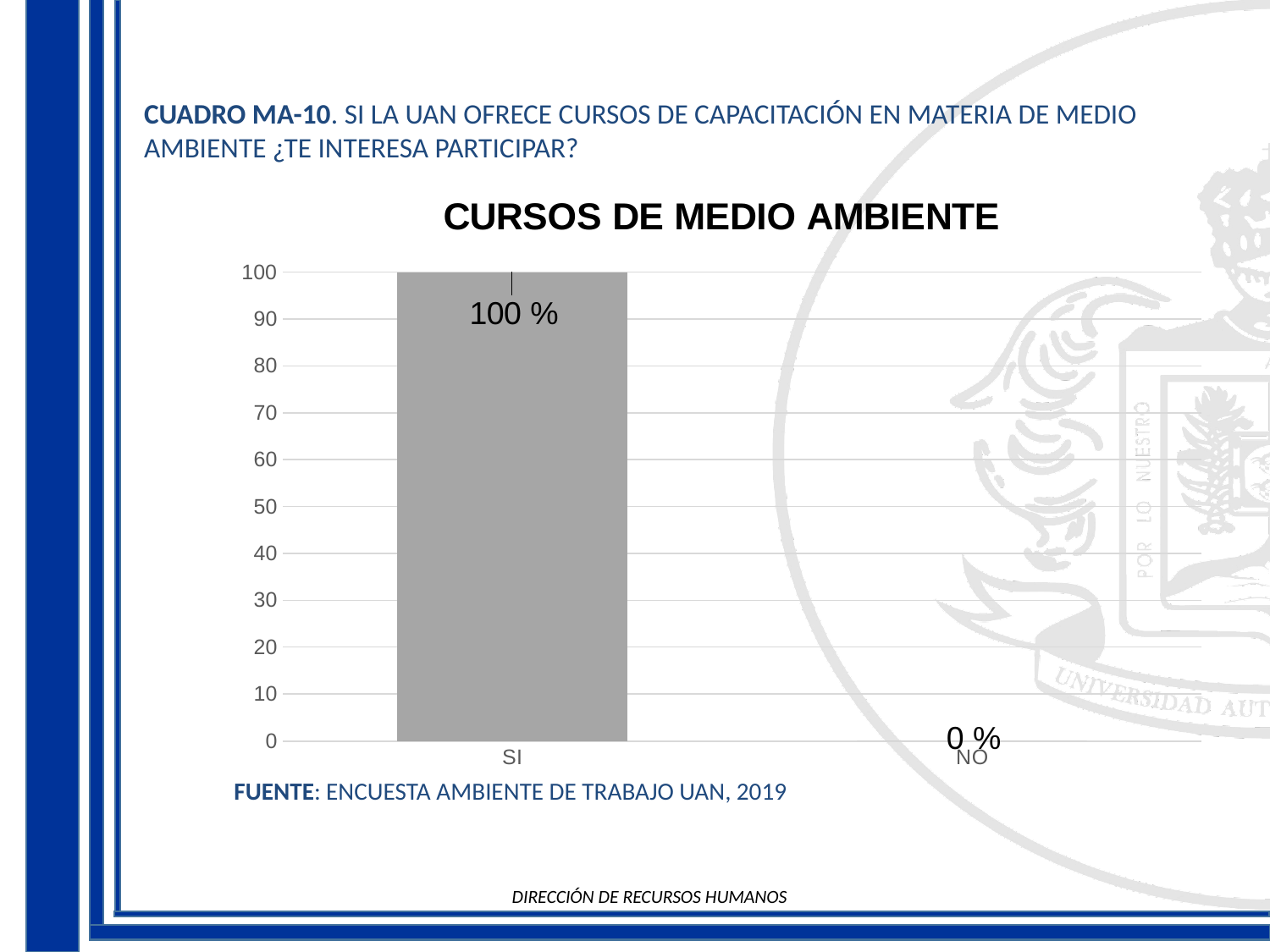
What is the title of the chart? CURSOS DE MEDIO AMBIENTE Is the value for SI greater or less than 50? greater What is the value for NO in the chart? 0 % What is the value for SI in the chart? 100 % Which is larger, the value for SI or the value for NO? SI What is the difference between the values for SI and NO? 100 % What kind of chart is shown on the slide? bar chart What is the highest value shown on the y axis of the chart? 100 Which category has the highest value? SI How many categories are shown on the x axis of the chart? 2 Do the values rise or fall from SI to NO along the x axis? fall Which category has the lowest value? NO